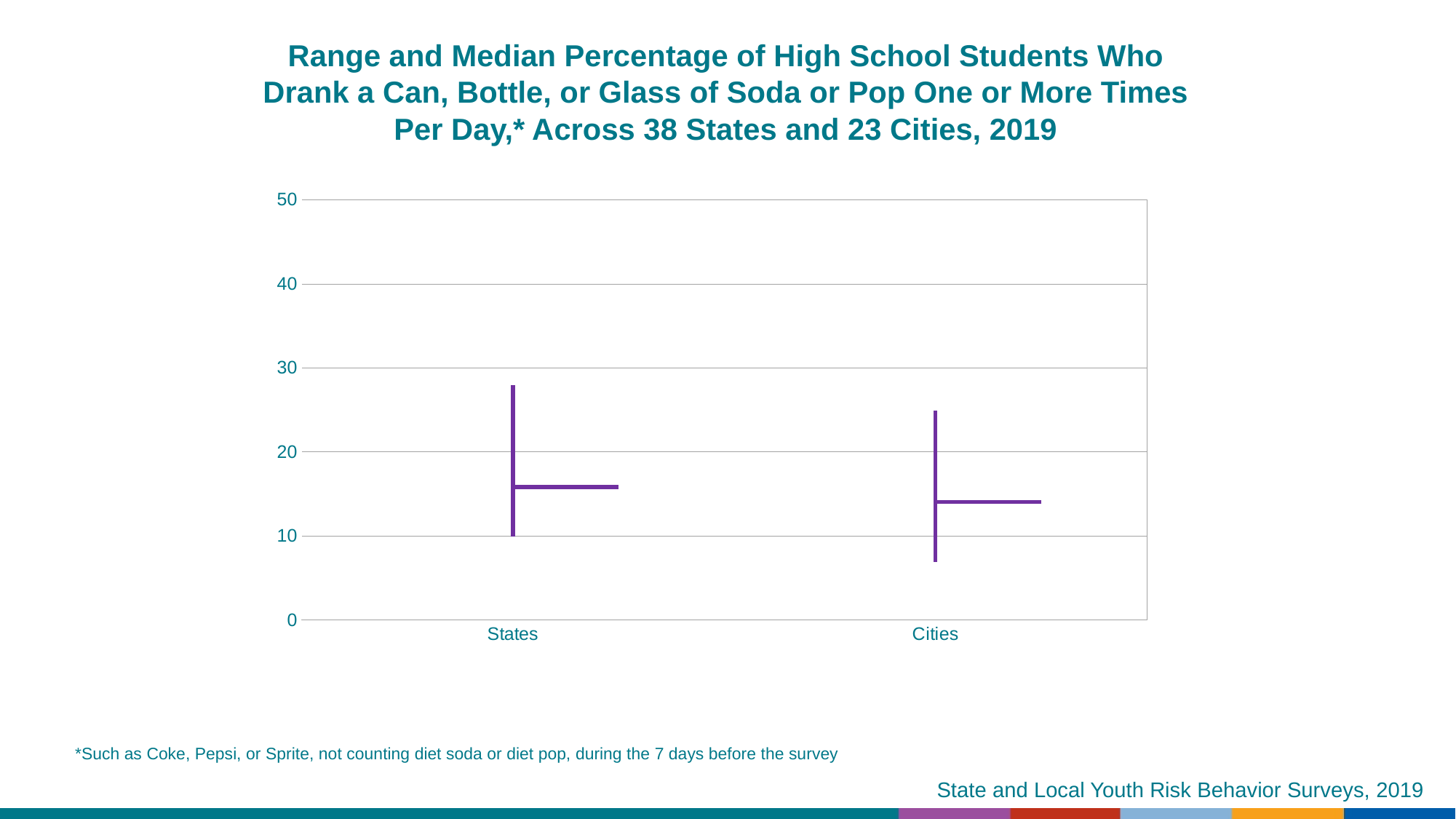
According to the title, how many states and cities are included in the chart? 38 states and 23 cities Is the top of the range for Cities greater or less than 30? less Is the top of the range for States greater or less than 20? greater Which category has the higher top of its range, States or Cities? States Is the bottom of the range for Cities greater or less than 10? less What kind of chart is shown on the slide? A range (high-low) chart showing range and median How many categories are shown on the x axis? 2 Which category has the lower bottom of its range, States or Cities? Cities What is the maximum value shown on the y axis? 50 Which category has the higher median value, States or Cities? States